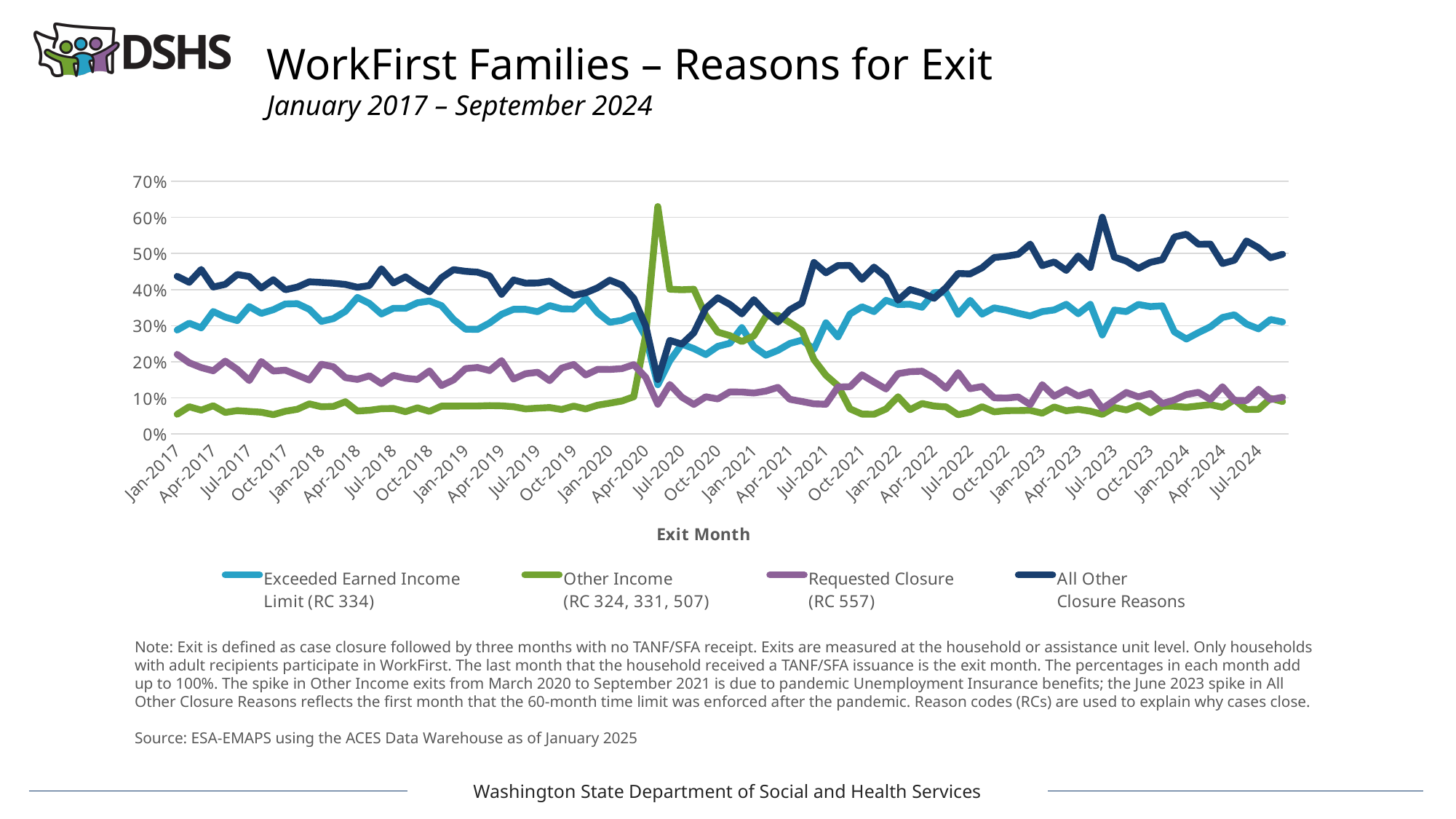
Does the Other Income (RC 324, 331, 507) series rise or fall between Jul-2020 and Oct-2021? fall What is the label of the x axis? Exit Month Is the peak value of Other Income (RC 324, 331, 507) in mid-2020 greater or less than 50%? greater What kind of chart is shown on the slide? line chart Which series is drawn in green? Other Income (RC 324, 331, 507) Is the value for Exceeded Earned Income Limit (RC 334) in Jan-2017 greater or less than 20%? greater How many series does the legend list? 4 Which series has the lowest value in Jan-2017? Other Income (RC 324, 331, 507) Is the value for Other Income (RC 324, 331, 507) in Jan-2017 greater or less than 10%? less In Jul-2024, which is larger: Exceeded Earned Income Limit (RC 334) or Requested Closure (RC 557)? Exceeded Earned Income Limit (RC 334) Which series has the highest value in Jan-2017? All Other Closure Reasons